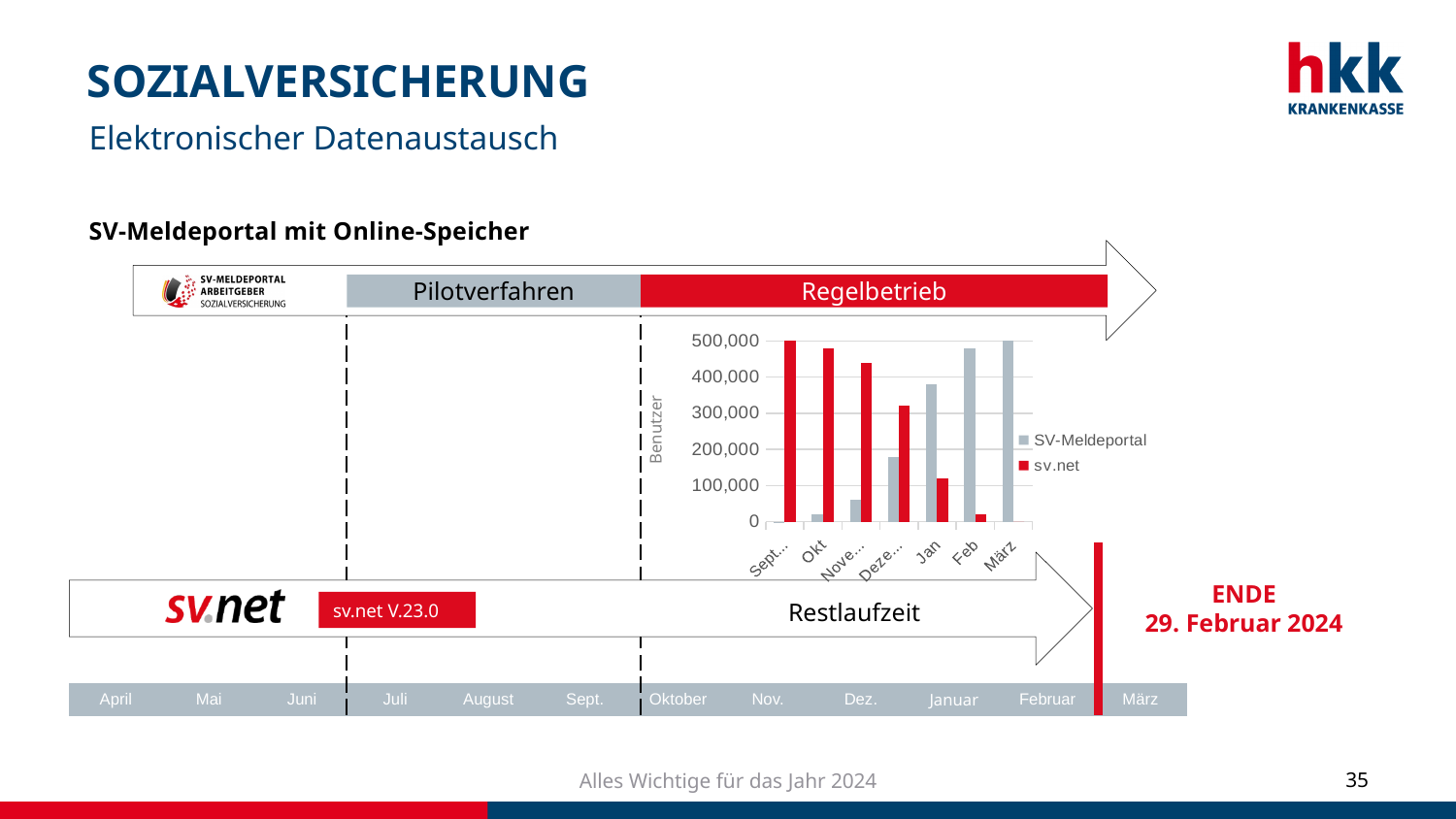
Is the sv.net value for Jan greater or less than 200,000? less Is the SV-Meldeportal value for Jan greater or less than 300,000? greater How many month categories are shown on the x axis of the chart? 7 Do the sv.net values rise or fall from Sept to März? fall In Feb, which series has the larger value, SV-Meldeportal or sv.net? SV-Meldeportal Do the SV-Meldeportal values rise or fall from Sept to März? rise In Okt, which series has the larger value, SV-Meldeportal or sv.net? sv.net How many series does the chart's legend list? 2 What is the label on the chart's vertical axis? Benutzer Which month has the lowest sv.net value? März Is the sv.net value for Deze... greater or less than 400,000? less What kind of chart is shown on the slide? bar chart